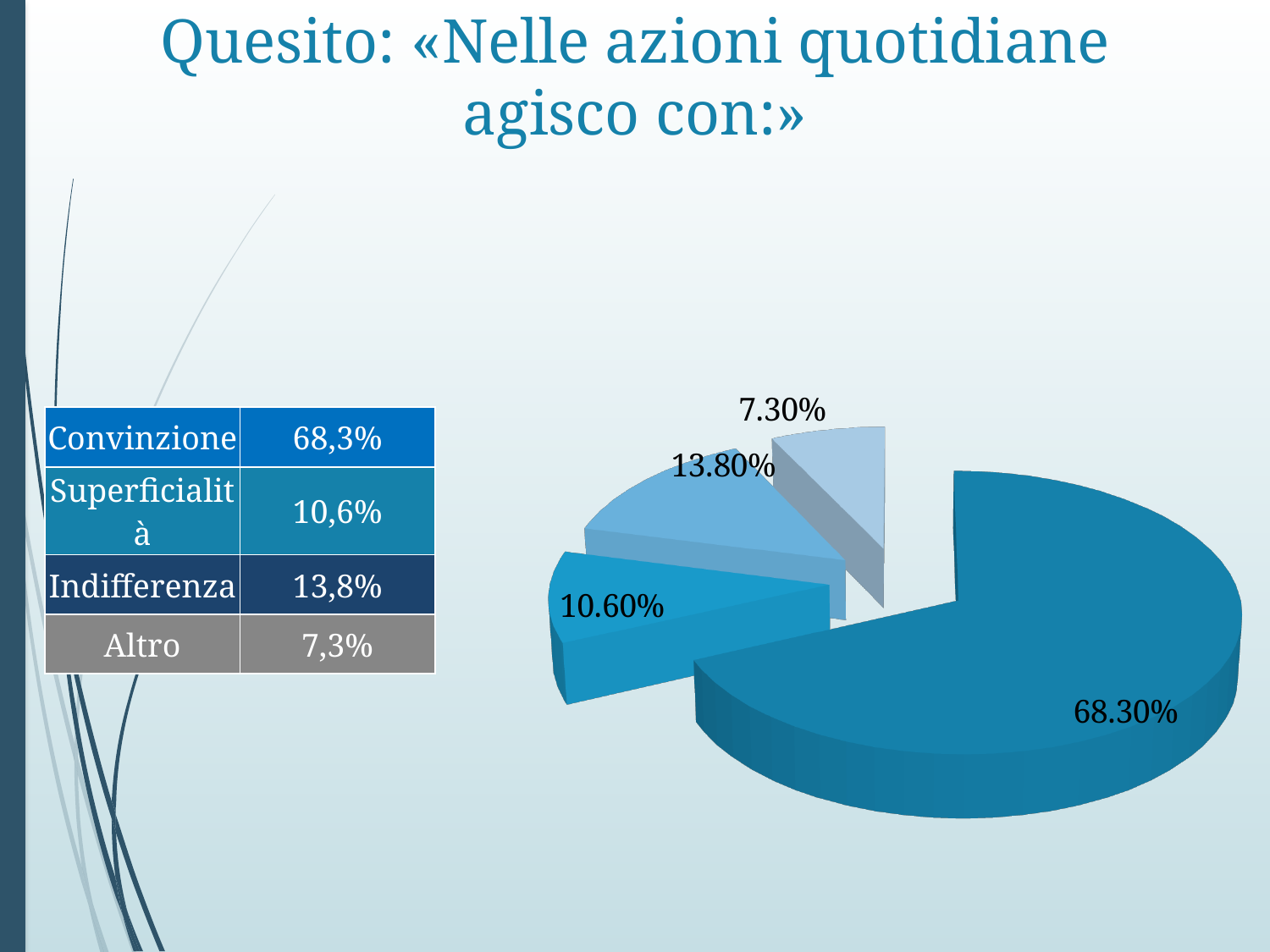
According to the table, which category corresponds to the largest slice of the pie chart? Convinzione What is the smallest slice's data label on the pie chart? 7.30% What is the difference between the pie chart's largest slice (68.30%) and its smallest slice (7.30%)? 61.00% What share of the pie does the Indifferenza slice represent, as labelled on the pie chart? 13.80% What is the difference between the slices labelled 13.80% and 10.60% on the pie chart? 3.20% What kind of chart is shown on the slide? pie chart What is the title of the slide containing the pie chart? Quesito: «Nelle azioni quotidiane agisco con:» How many slices does the pie chart have? 4 What share of the pie does the Superficialità slice represent, as labelled on the pie chart? 10.60% What is the largest slice's data label on the pie chart? 68.30% Which slice is larger on the pie chart: the one labelled 13.80% or the one labelled 10.60%? 13.80% According to the table, which category corresponds to the smallest slice of the pie chart? Altro